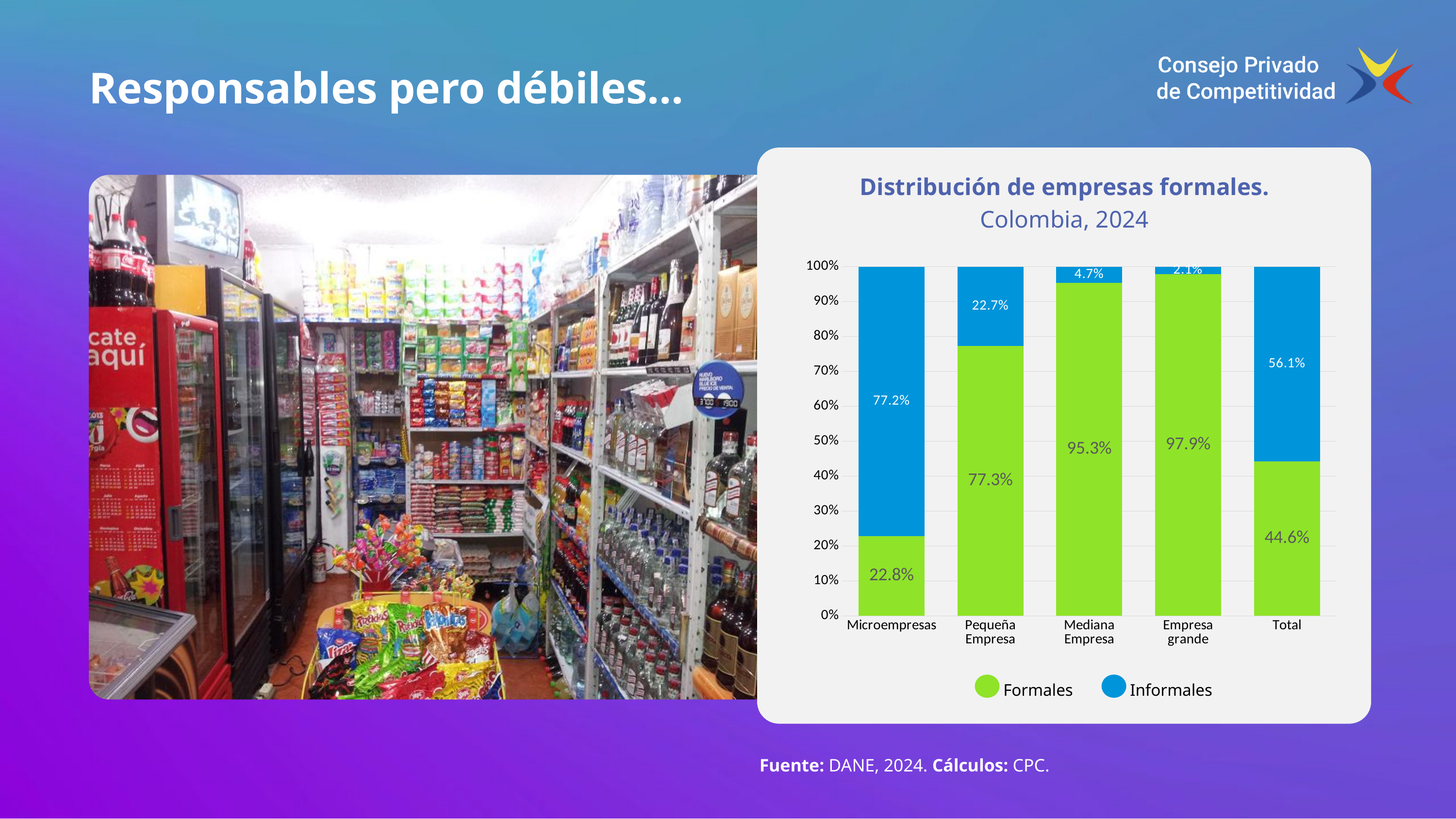
What is the Informales value for Pequeña Empresa? 22.7% Which category has the lowest Formales share? Microempresas What is the Informales value for Total? 56.1% What is the Formales value for Mediana Empresa? 95.3% How many categories are shown on the x axis? 5 What kind of chart is shown on the slide? Stacked bar chart Which is larger, the Informales value for Microempresas or the Informales value for Total? Microempresas Which category has the highest Formales share? Empresa grande How many series does the legend list? 2 What is the difference between the Formales values for Empresa grande and Microempresas? 75.1% Is the Formales value for Pequeña Empresa greater or less than 70%? greater What is the Formales value for Microempresas? 22.8%